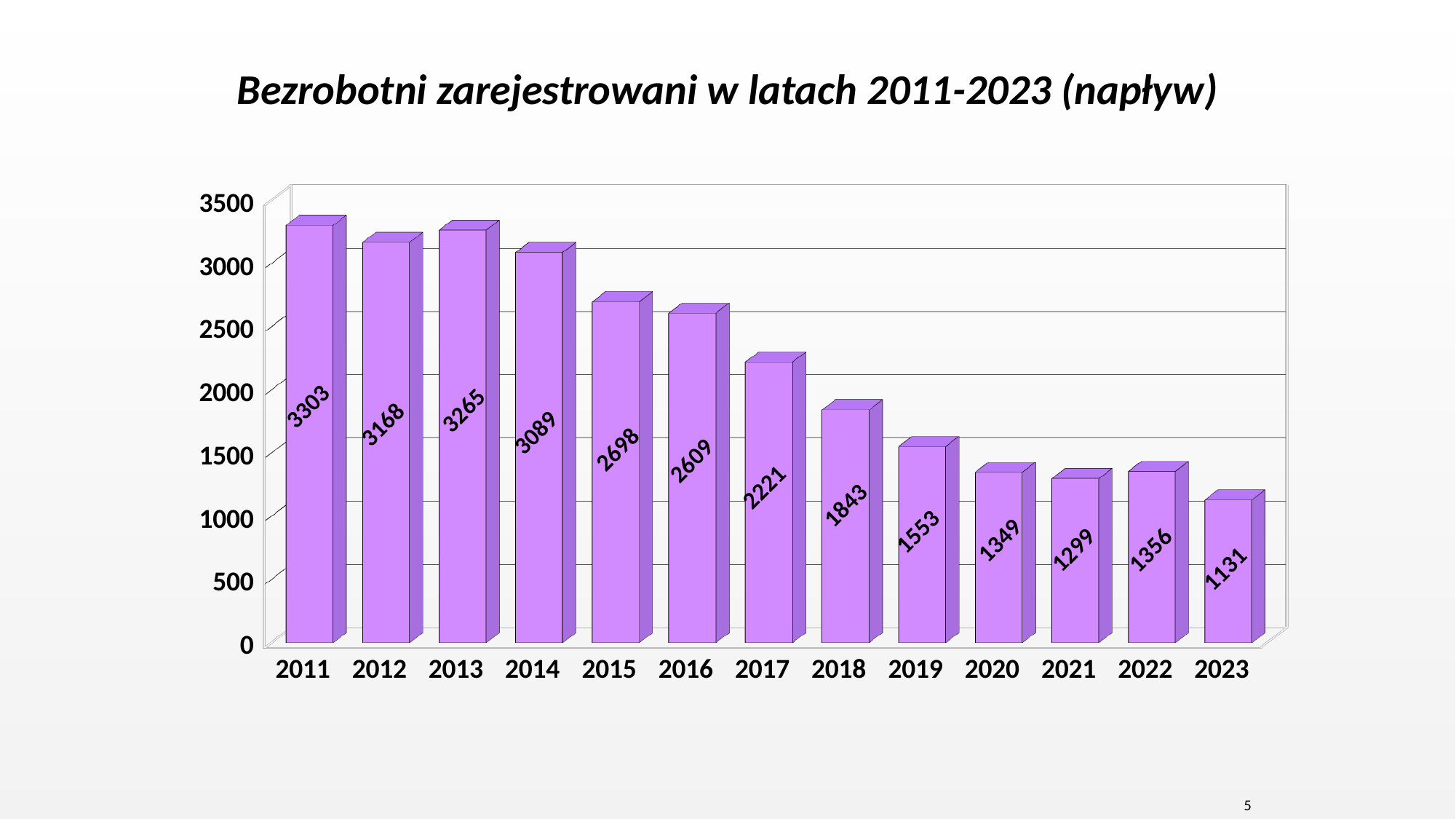
How many years are shown on the x axis? 13 Which year has the highest value? 2011 What is the value for 2019? 1553 Do the values generally rise or fall from 2011 to 2023? fall Which is larger, the value for 2021 or the value for 2022? 2022 What is the value for 2011? 3303 What is the difference between the values for 2017 and 2018? 378 What is the difference between the values for 2011 and 2023? 2172 What is the value for 2023? 1131 Is the value for 2016 greater or less than 2500? greater Which year has the lowest value? 2023 What kind of chart is shown on the slide? bar chart